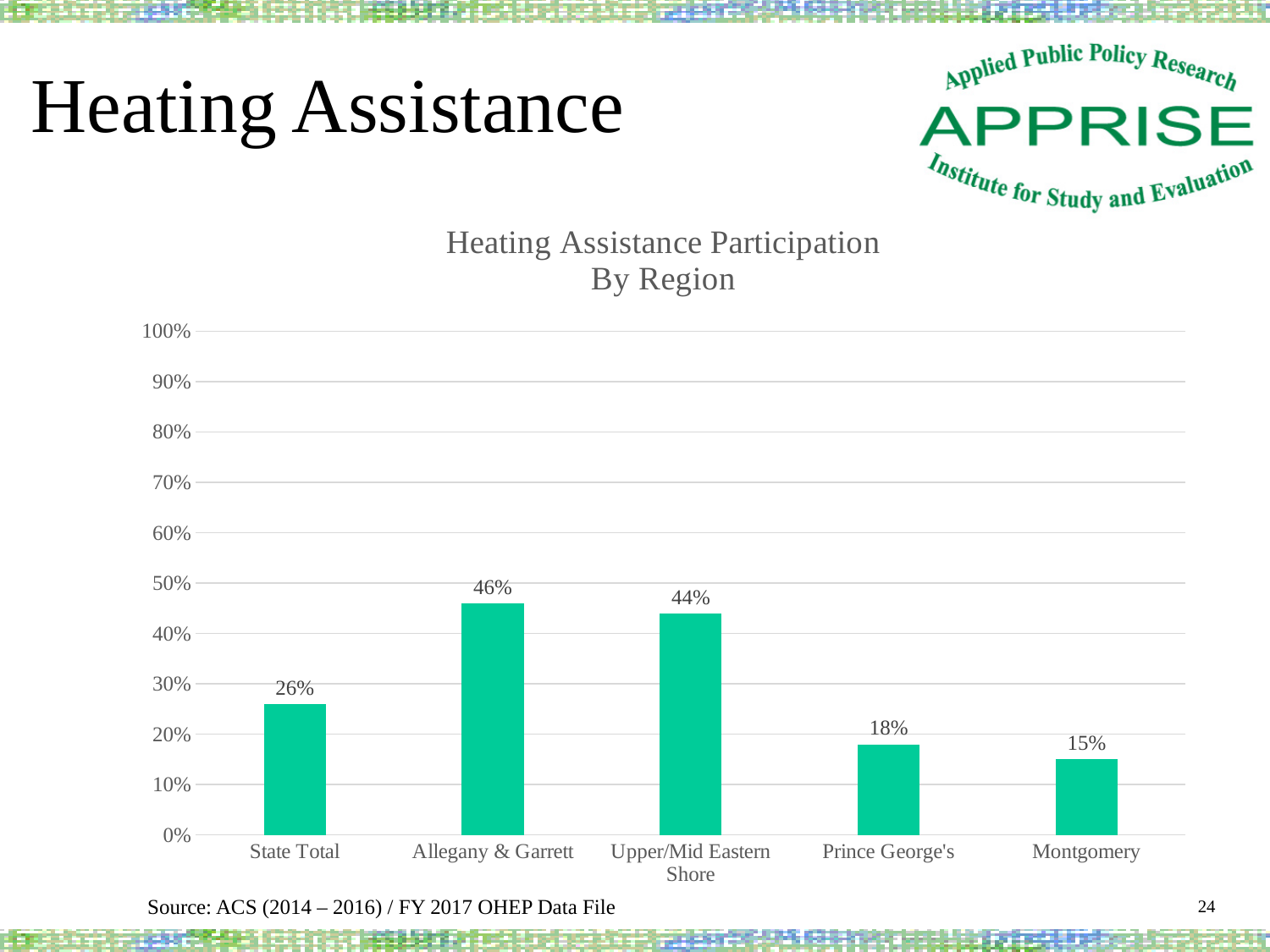
What is the heating assistance participation rate for Allegany & Garrett? 46% Which region has the lowest heating assistance participation rate? Montgomery What is the difference in participation rate between Upper/Mid Eastern Shore and the State Total? 18% What is the heating assistance participation rate for Prince George's? 18% Which region has the highest heating assistance participation rate? Allegany & Garrett What is the heating assistance participation rate for the State Total? 26% What is the difference in participation rate between Allegany & Garrett and Montgomery? 31% What is the heating assistance participation rate for Montgomery? 15% Which has a higher participation rate, Prince George's or the State Total? State Total Is the participation rate for Upper/Mid Eastern Shore greater or less than 40%? greater How many regions are shown on the chart? 5 What type of chart is shown on the slide? Bar chart